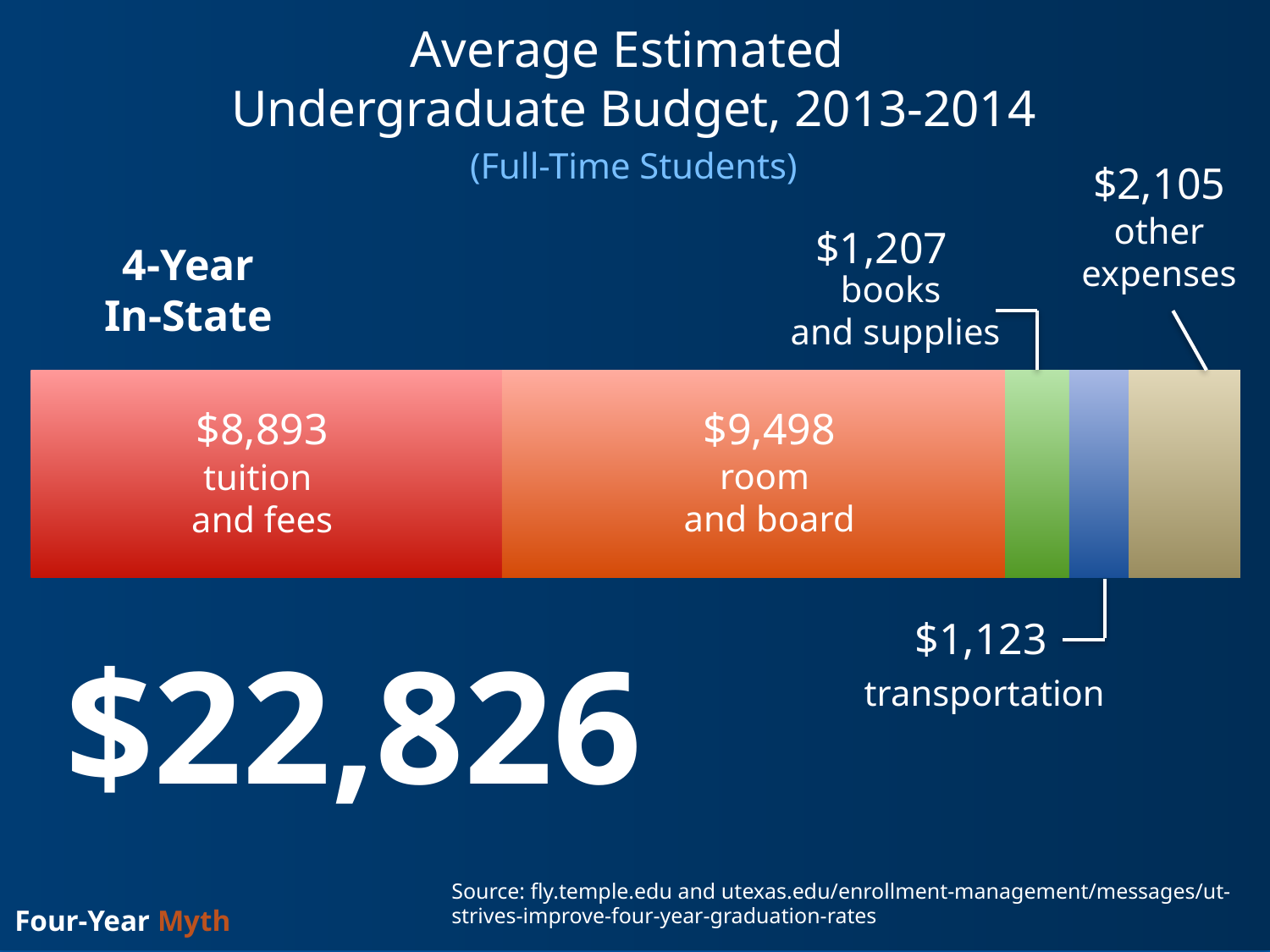
What is the value for tuition and fees? $8,893 What is the value for books and supplies? $1,207 What is the total of the stacked bar? $22,826 How many budget categories make up the stacked bar? 5 What is the value for transportation? $1,123 Which is larger, tuition and fees or room and board? room and board Which budget category has the highest value? room and board What is the value for room and board? $9,498 What is the difference between room and board and tuition and fees? $605 What is the difference between other expenses and books and supplies? $898 Which budget category has the lowest value? transportation What is the value for other expenses? $2,105